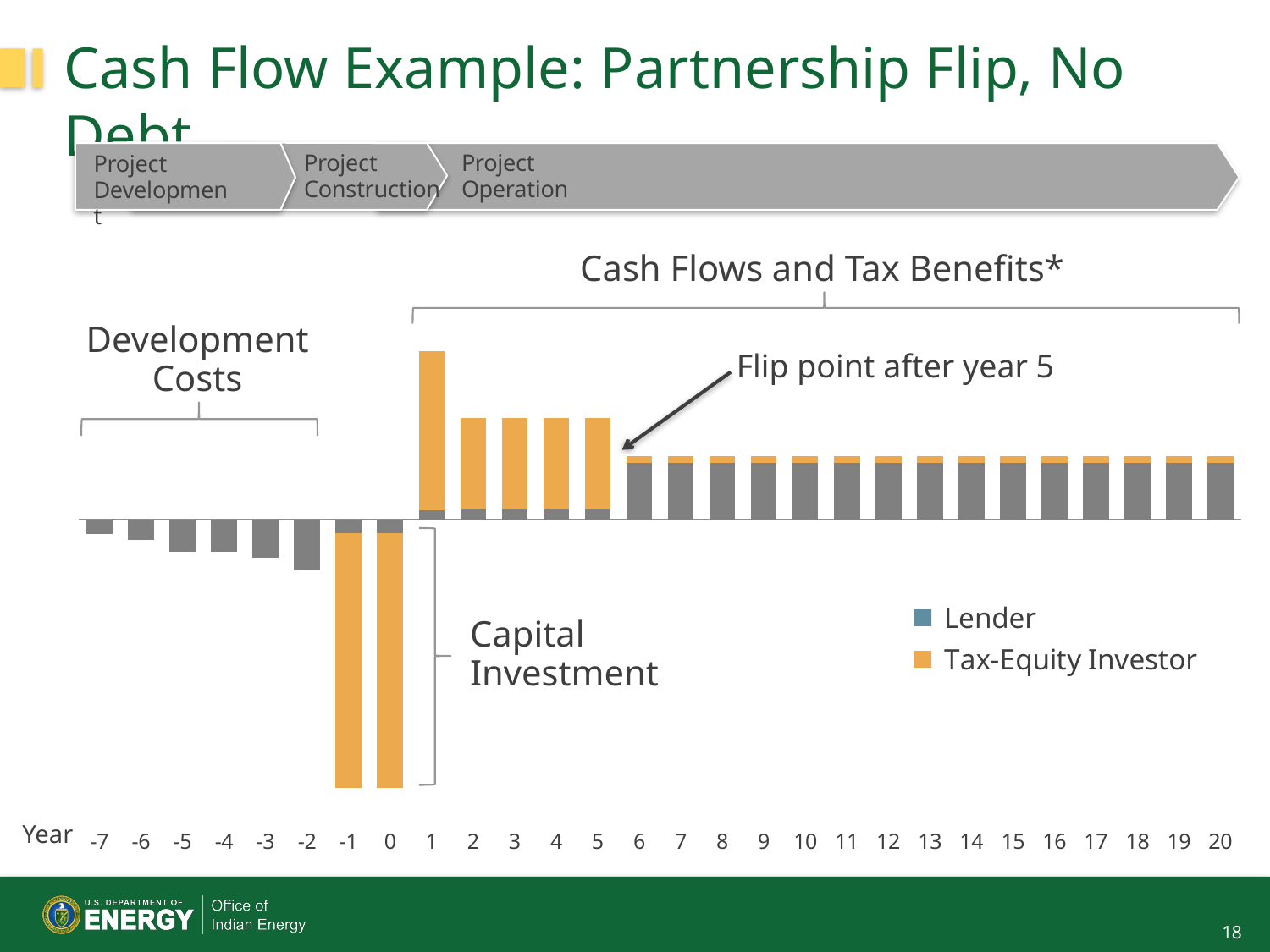
What is the first year label on the x axis of the chart? -7 From year 6 to year 20, do the bars rise, fall, or stay flat? Stay flat How many series does the chart legend list? 2 After which year does the chart indicate the flip point occurs? Year 5 Is the positive bar for year 1 larger or smaller than the positive bar for year 2? Larger Is the positive bar for year 5 larger or smaller than the positive bar for year 6? Larger Which two series are listed in the chart legend? Lender and Tax-Equity Investor In which year does the chart show the tallest positive bar? Year 1 How many years are shown along the x axis of the chart? 28 What kind of chart is shown on the slide? Stacked bar chart Do the development cost bars from year -7 to year -2 get larger or smaller in magnitude? Larger